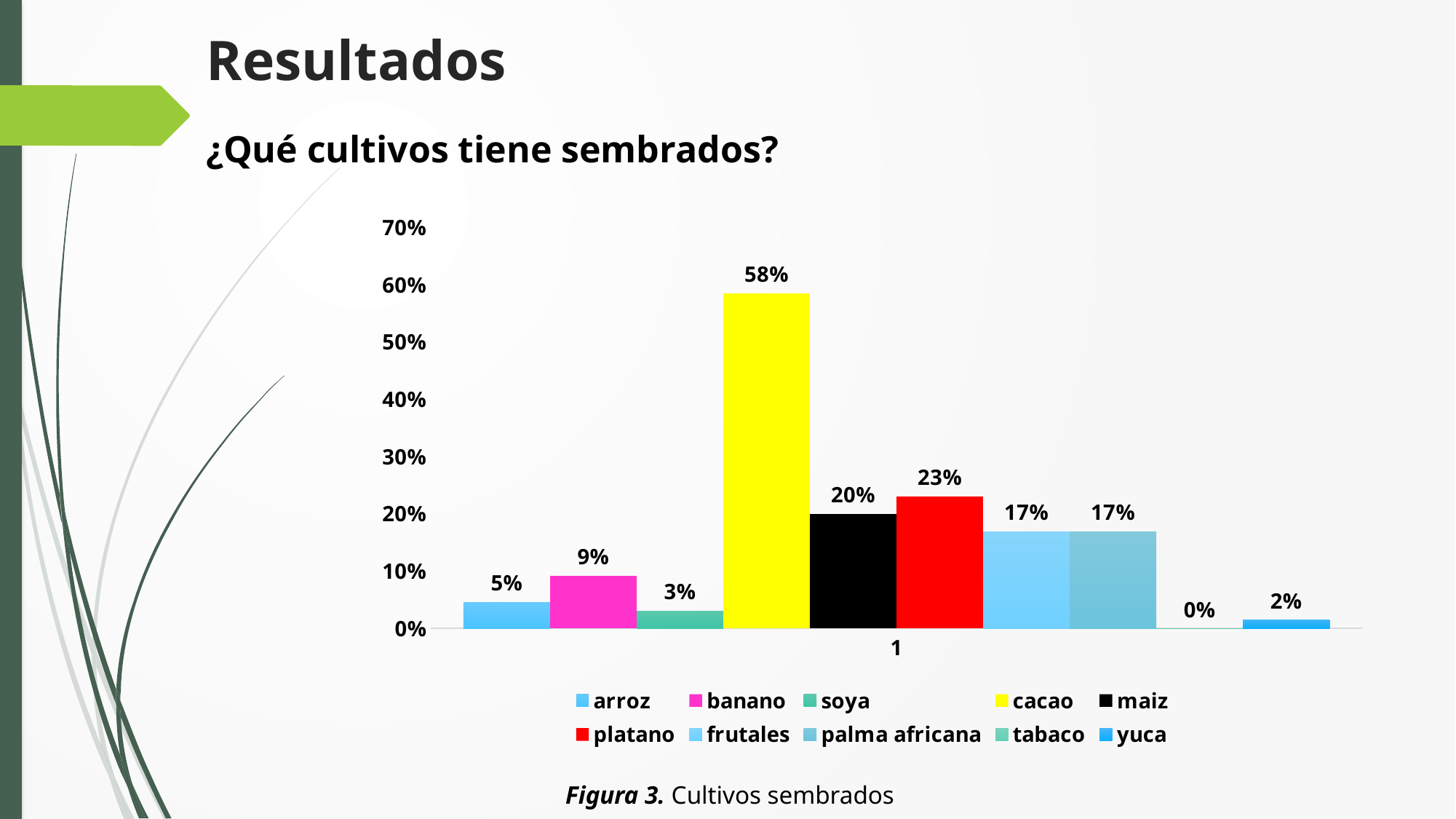
What is the caption of the figure below the chart? Figura 3. Cultivos sembrados What is the difference between the values for maiz and arroz? 15% What is the value for platano? 23% What type of chart is shown on the slide? bar chart What is the value for cacao? 58% Which crop has the highest value? cacao Which is larger, the value for maiz or the value for platano? platano Which crop has the lowest value? tabaco How many series does the legend list? 10 What is the difference between the values for cacao and platano? 35% What is the value for banano? 9% What is the value for tabaco? 0%